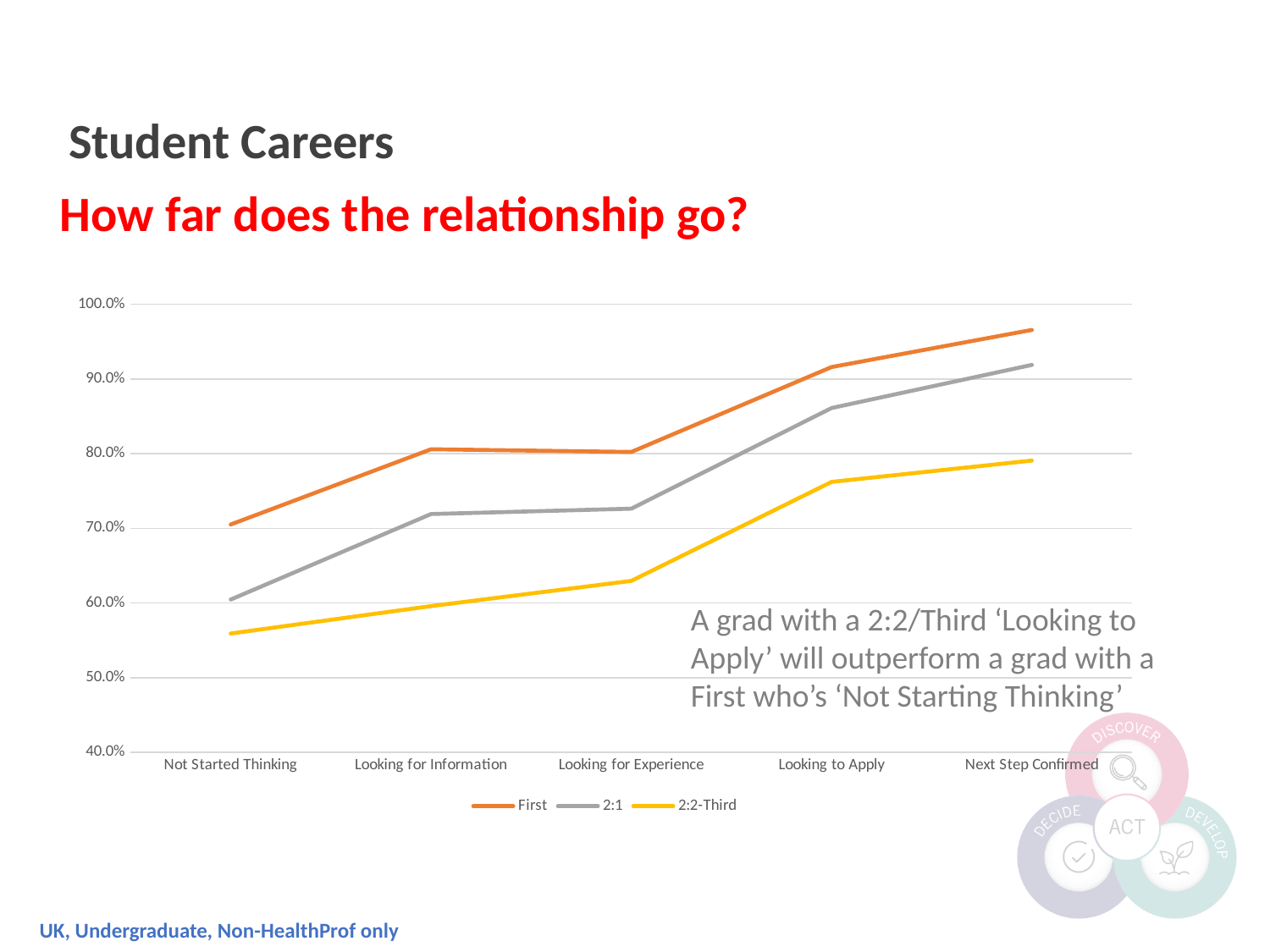
How many categories are shown along the x axis? 5 Is the value for 2:1 at Looking to Apply greater or less than 80%? greater What kind of chart is shown on the slide? line chart For the 2:2-Third series, which category has the lowest value? Not Started Thinking Is the value for 2:1 at Not Started Thinking greater or less than 70%? less How many series does the legend list? 3 Is the value for First at Next Step Confirmed greater or less than 90%? greater Do the values for the First series rise or fall from Not Started Thinking to Next Step Confirmed? rise At Looking to Apply, which is larger: the value for First or the value for 2:2-Third? First Which series has the highest value at Next Step Confirmed? First What colour is the line for the First series? orange